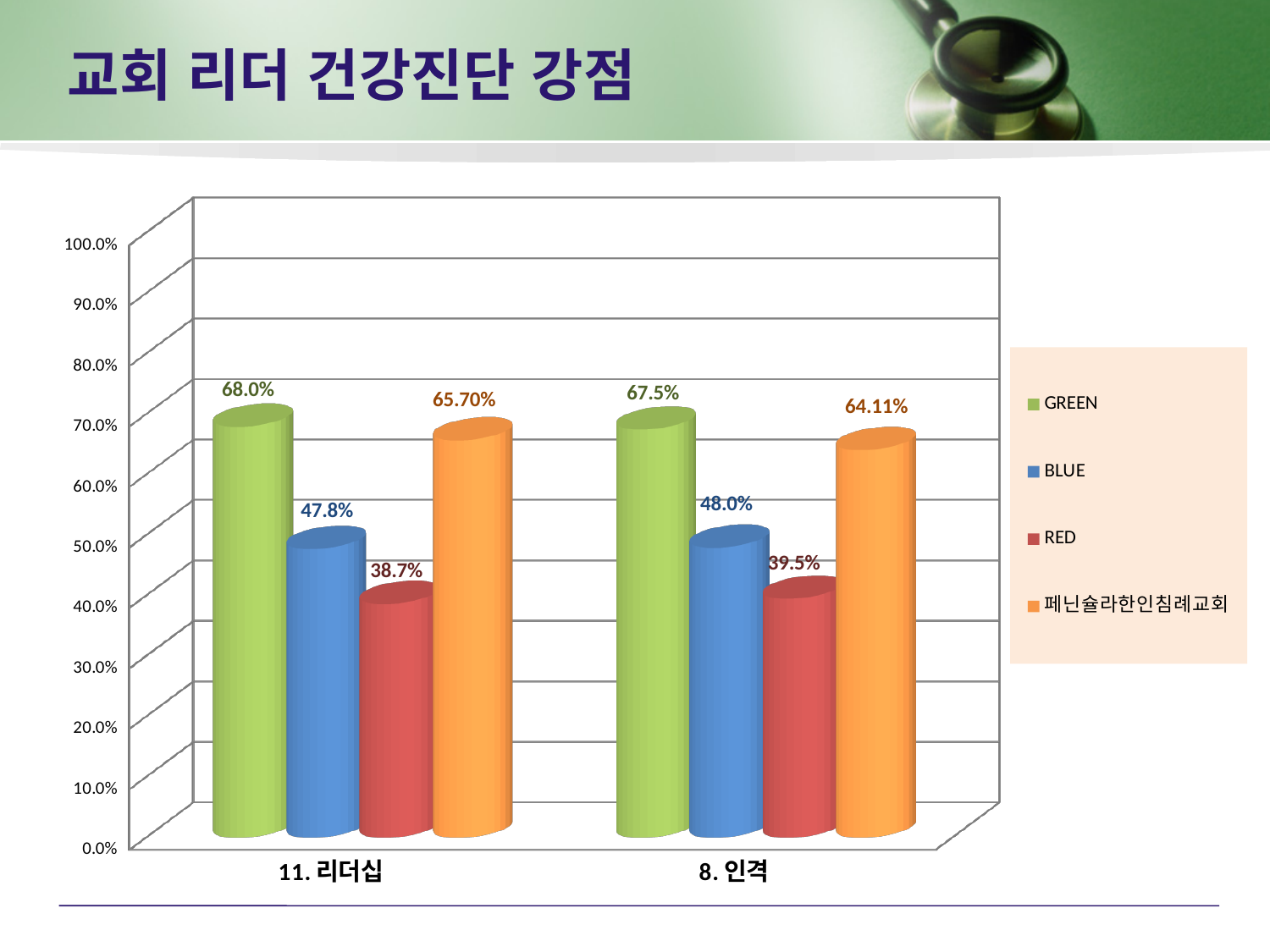
Which is larger: the 페닌슐라한인침례교회 value for 11. 리더십 or for 8. 인격? 11. 리더십 What is the difference between the GREEN and BLUE values in the 11. 리더십 category? 20.2% What is the value for 페닌슐라한인침례교회 in the 8. 인격 category? 64.11% What kind of chart is shown on the slide? Bar chart What is the value for RED in the 11. 리더십 category? 38.7% Which series has the highest value in the 8. 인격 category? GREEN How many categories are shown on the x axis? 2 Which series has the lowest value in the 11. 리더십 category? RED How many series does the legend list? 4 What colour represents the RED series in the chart? Red What is the value for GREEN in the 11. 리더십 category? 68.0% What is the value for BLUE in the 8. 인격 category? 48.0%